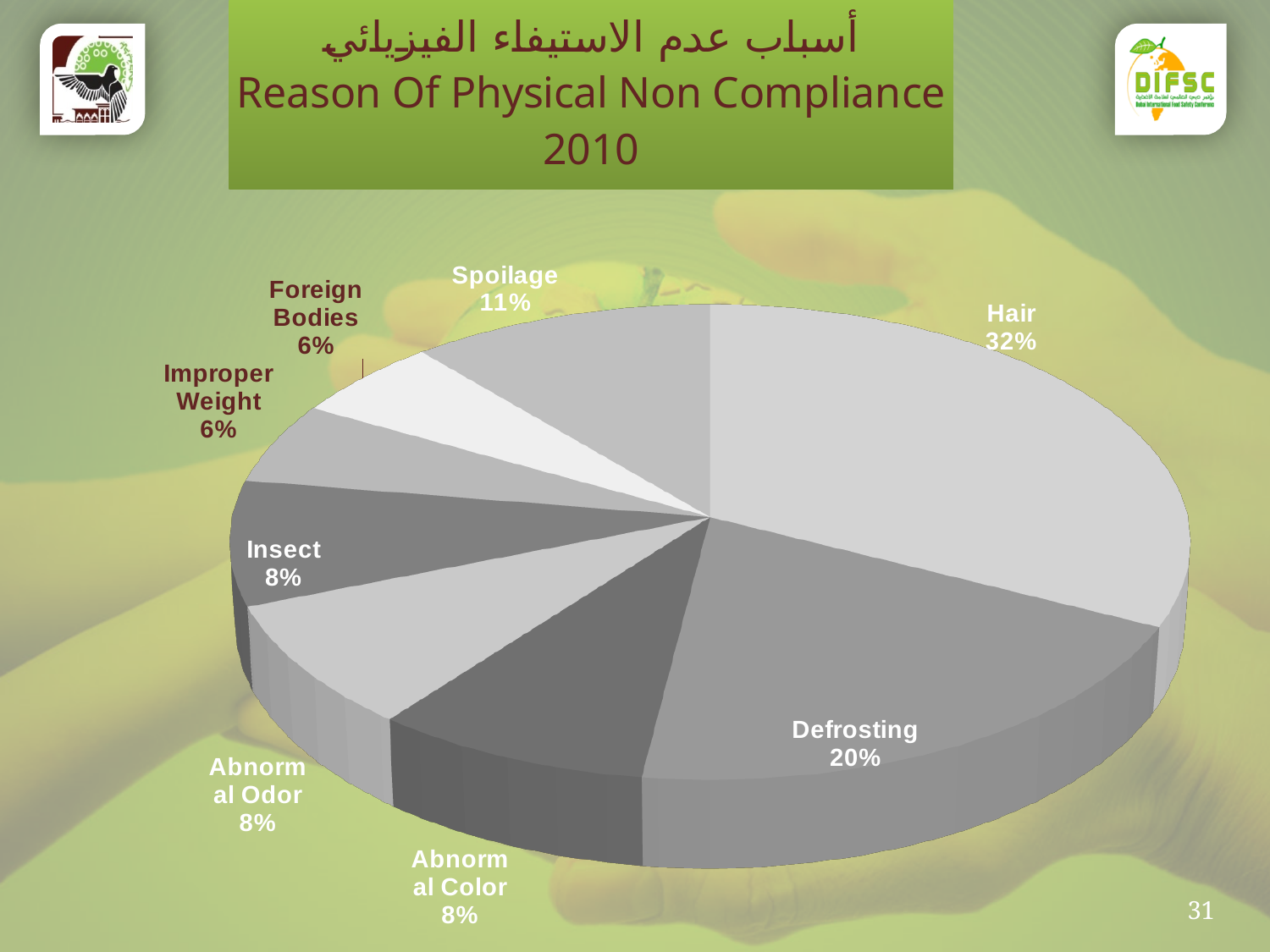
What percentage is shown for Spoilage? 11% What is the value shown for Defrosting? 20% What kind of chart is shown on the slide? pie chart What is the value shown for Improper Weight? 6% Which reason has the largest slice of the pie? Hair What percentage is shown for Insect? 8% Which is larger, the slice for Defrosting or the slice for Spoilage? Defrosting What year does the chart title refer to? 2010 What is the combined share of Foreign Bodies and Improper Weight? 12% What is the difference in percentage points between Hair and Defrosting? 12 What share of the pie does Hair account for? 32% How many slices does the pie chart have? 8